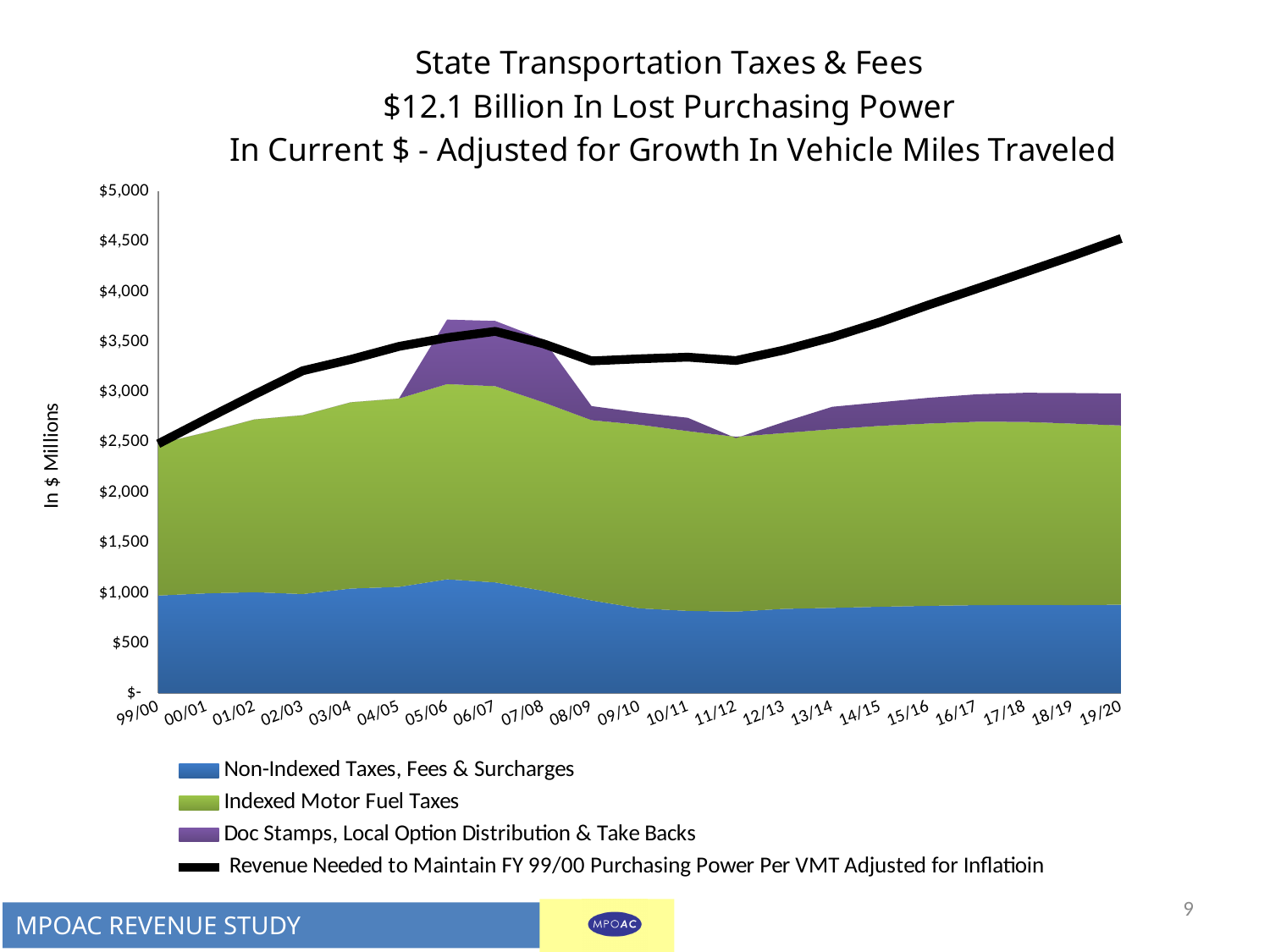
What kind of chart is shown on the slide? Stacked area chart with a line overlay Is the value of the black 'Revenue Needed' line in 11/12 greater or less than $3,000? greater What is the label on the vertical axis? In $ Millions Which series is shown in purple? Doc Stamps, Local Option Distribution & Take Backs In which fiscal year does the black 'Revenue Needed' line reach its highest value? 19/20 In which fiscal year does the total stacked area (all three revenue sources combined) reach its highest point? 05/06 How many series does the legend list? 4 Is the value of Non-Indexed Taxes, Fees & Surcharges in 10/11 greater or less than $1,000? less Is the total of the stacked areas in 05/06 greater or less than $3,500? greater Does the black 'Revenue Needed to Maintain FY 99/00 Purchasing Power' line rise or fall overall from 99/00 to 19/20? Rise How many fiscal years are shown along the x axis? 21